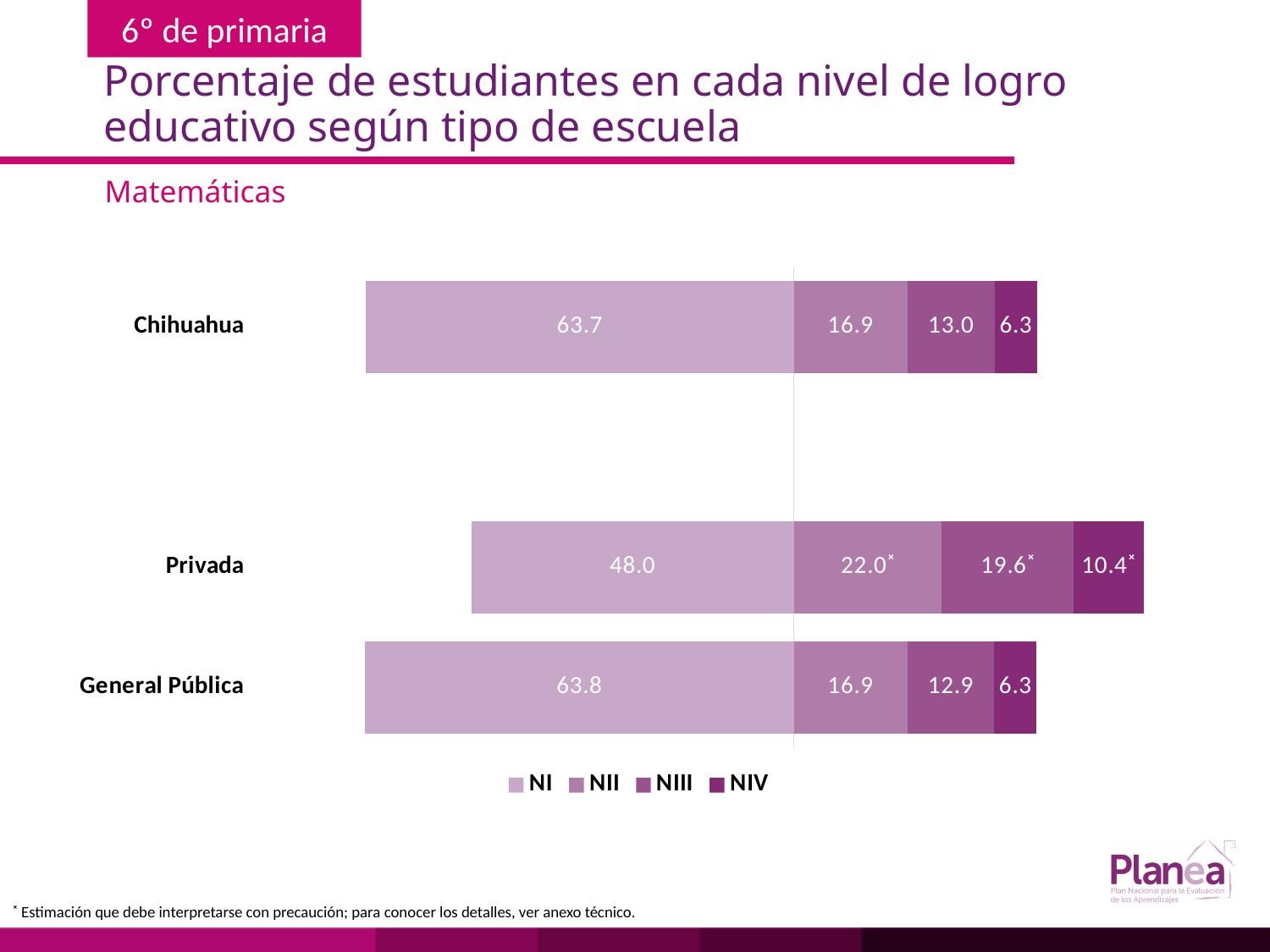
How many series does the legend list? 4 What is the NI value for Chihuahua? 63.7 What is the difference between the NII value for Privada and the NII value for Chihuahua? 5.1 What is the NIV value for General Pública? 6.3 Which school type has the highest NIV value? Privada What kind of chart is shown on the slide? Stacked bar chart Which subject does the chart refer to? Matemáticas What is the NI value for Privada? 48.0 Which has the larger NIII value, Chihuahua or General Pública? Chihuahua How many categories (bars) are shown in the chart? 3 What is the total of the stacked bar for Chihuahua? 99.9 Which category has the lowest NI value? Privada